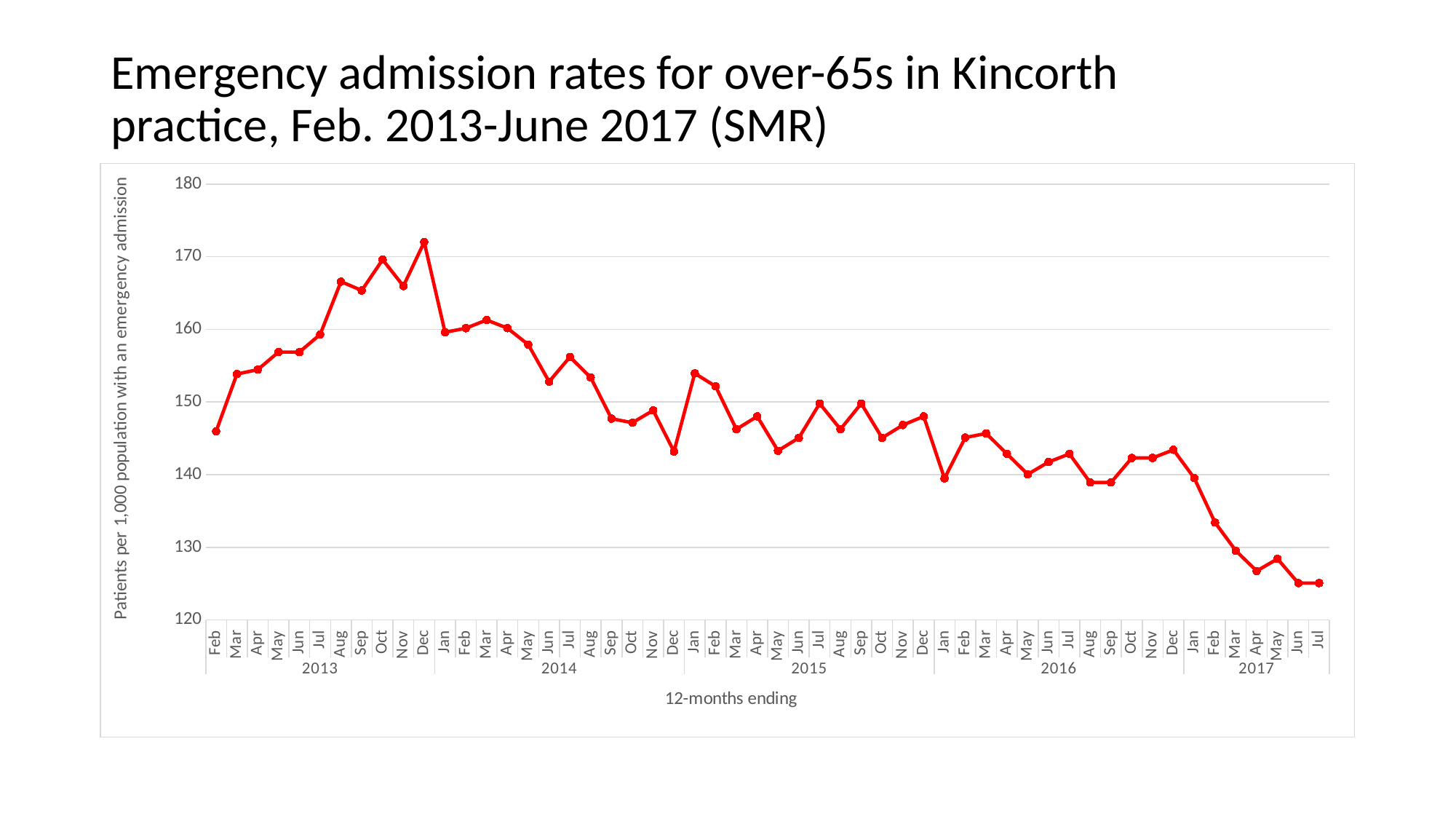
Which is larger, the value for Feb 2013 or the value for Feb 2017? Feb 2013 Is the value for Oct 2013 greater or less than 160? greater Is the value for Dec 2013 greater or less than 170? greater Which is larger, the value for Dec 2013 or the value for Dec 2016? Dec 2013 Is the value for Dec 2014 greater or less than 150? less What kind of chart is shown on the slide? line chart Which month has the highest emergency admission rate on the chart? Dec 2013 Overall, do the values rise or fall from Dec 2013 to Jul 2017? fall What is the title of the x axis? 12-months ending How many data points are plotted on the chart? 54